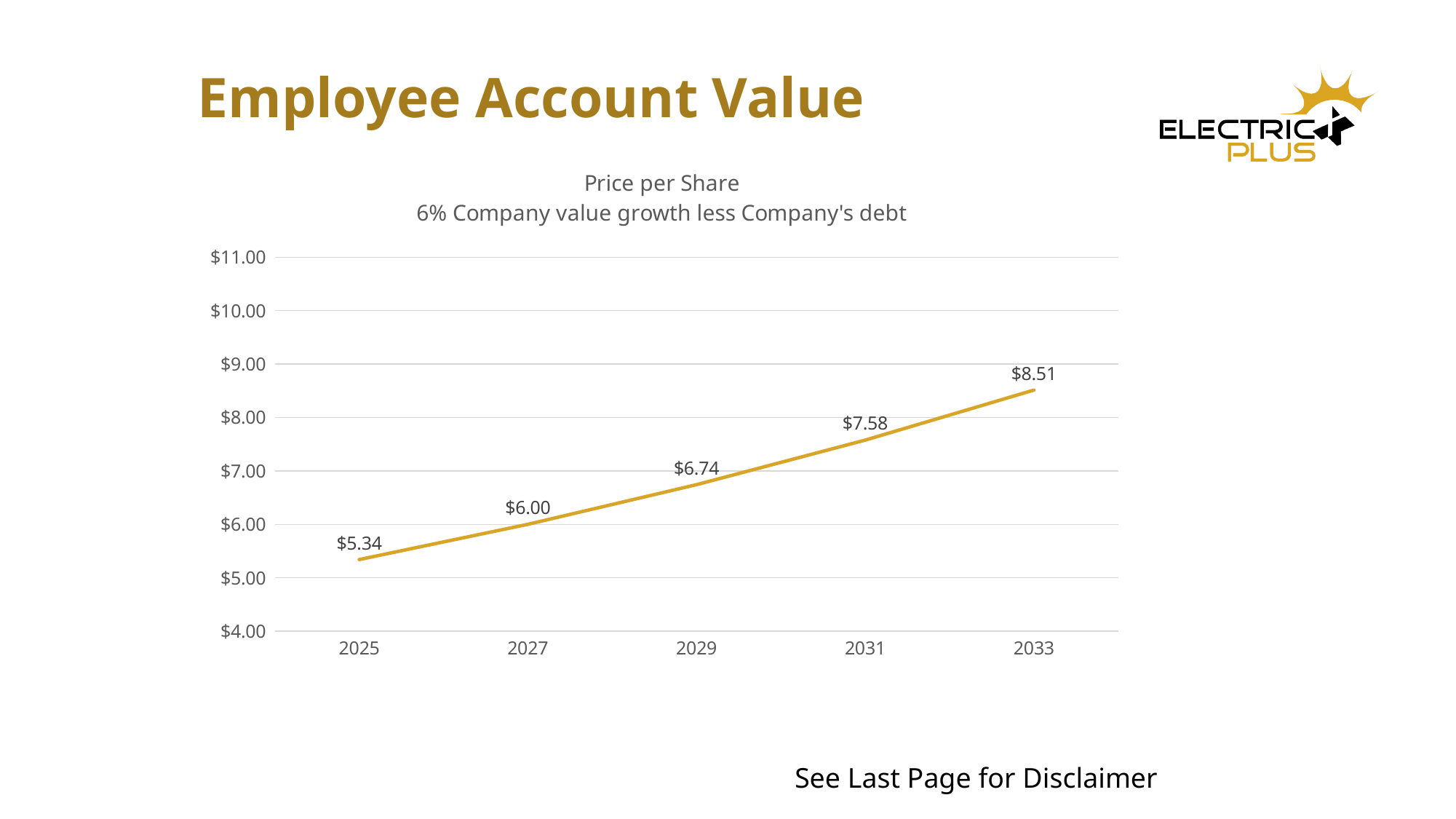
What kind of chart is shown on the slide? line chart Which year has the highest price per share? 2033 What is the difference between the price per share in 2033 and in 2025? $3.17 Which year has the lowest price per share? 2025 Which is larger, the price per share in 2027 or in 2031? 2031 Does the price per share rise or fall from 2025 to 2033? rise What is the price per share in 2025? $5.34 Is the price per share in 2029 greater or less than $7.00? less What is the price per share in 2033? $8.51 How many years are plotted on the chart? 5 What is the price per share in 2031? $7.58 What is the price per share in 2029? $6.74